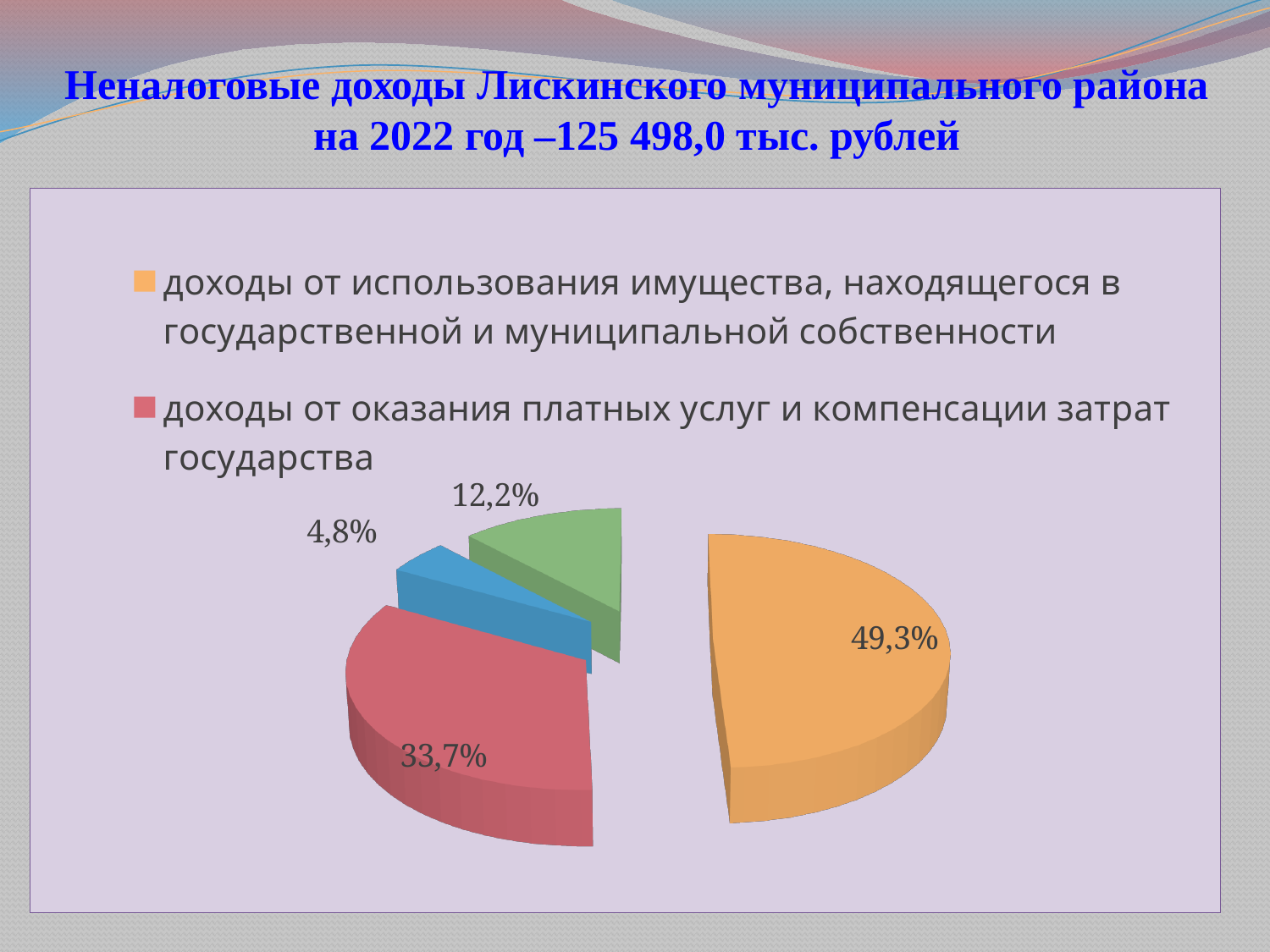
Which is larger: the slice for доходы от оказания платных услуг и компенсации затрат государства or the slice for доходы от использования имущества, находящегося в государственной и муниципальной собственности? доходы от использования имущества, находящегося в государственной и муниципальной собственности What share of the pie is labelled for доходы от оказания платных услуг и компенсации затрат государства? 33,7% By how many percentage points does the slice for доходы от использования имущества exceed the slice for доходы от оказания платных услуг и компенсации затрат государства? 15,6 Which category has the largest slice of the pie? доходы от использования имущества, находящегося в государственной и муниципальной собственности What kind of chart is shown on the slide? Pie chart What is the smallest percentage labelled on the pie chart? 4,8% What share of the pie is labelled for доходы от использования имущества, находящегося в государственной и муниципальной собственности? 49,3% What is the largest percentage labelled on the pie chart? 49,3% How many slices does the pie chart have? 4 What colour is the slice labelled 12,2%? Green What total amount of non-tax revenue for 2022 is stated in the slide title? 125 498,0 тыс. рублей How many entries does the legend list? 2